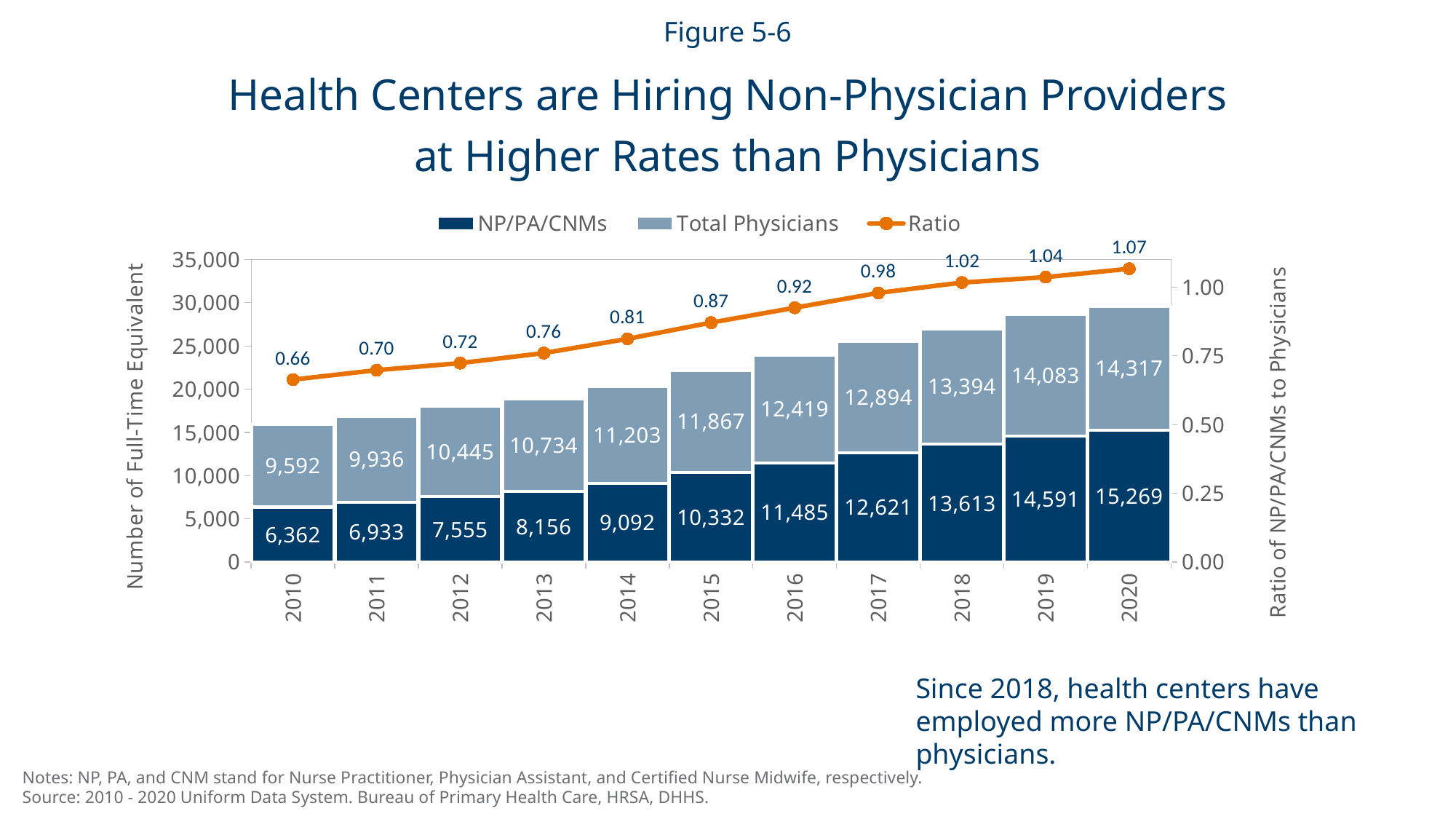
What is the difference between the Total Physicians value and the NP/PA/CNMs value in 2010? 3,230 Which is larger in 2019, the NP/PA/CNMs value or the Total Physicians value? NP/PA/CNMs Which year has the highest NP/PA/CNMs value? 2020 What is the Total Physicians value for 2018? 13,394 What is the NP/PA/CNMs value for 2015? 10,332 Does the Ratio rise or fall from 2010 to 2020? rises How many series does the legend list? 3 What is the Ratio value for 2013? 0.76 What is the label of the right-hand vertical axis? Ratio of NP/PA/CNMs to Physicians Which year has the lowest Total Physicians value? 2010 What is the total of the stacked bar for 2020? 29,586 How many years are shown on the x axis? 11